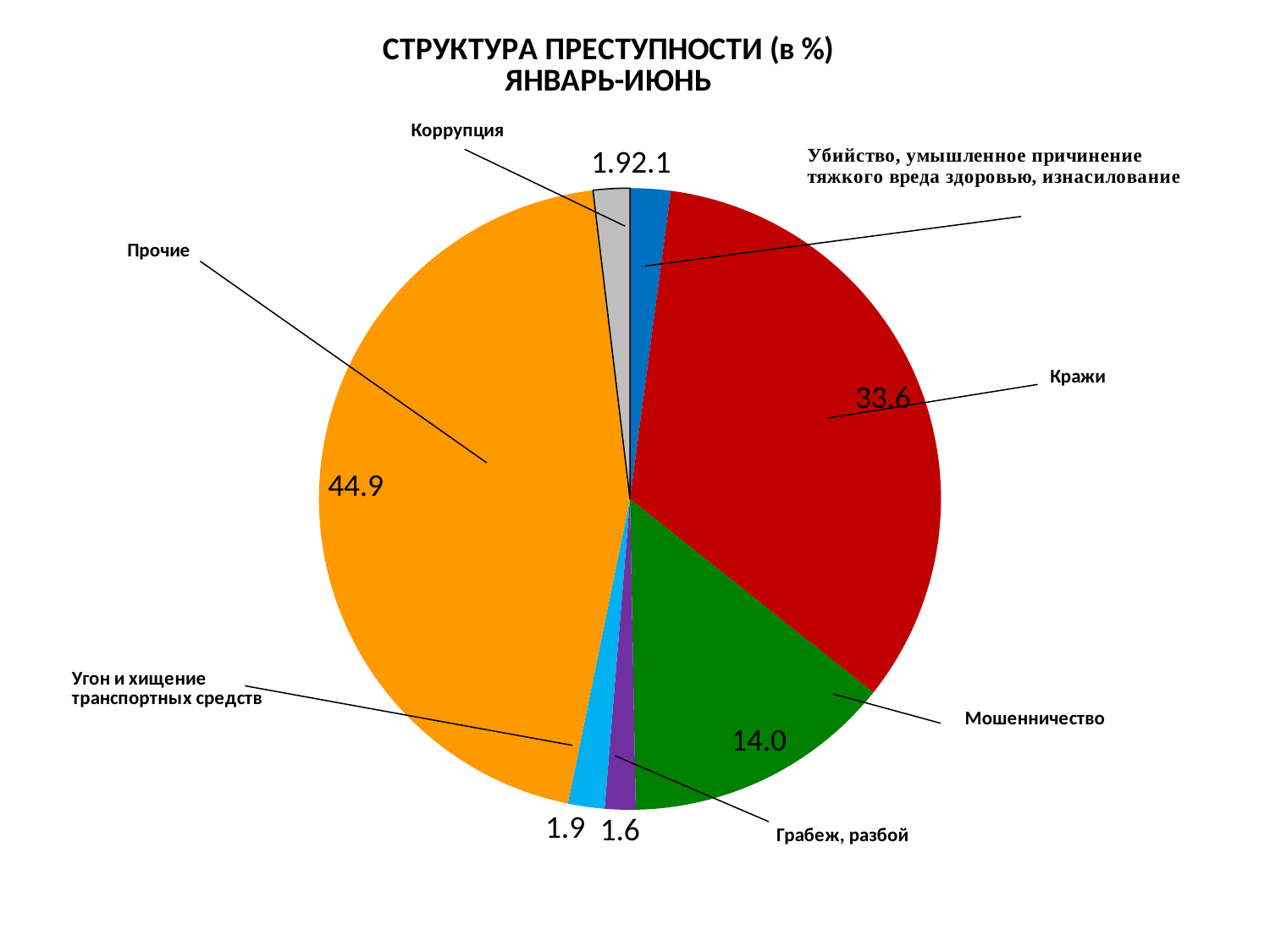
How many categories (slices) does the pie chart have? 7 What type of chart is shown on the slide? Pie chart What is the value shown for Мошенничество? 14.0 What is the value shown for Грабеж, разбой? 1.6 Which category has the largest slice of the pie? Прочие What is the difference between the values for Прочие and Кражи? 11.3 What share of the pie does the Кражи slice represent? 33.6 What is the value shown for the Прочие slice? 44.9 What is the title of the chart? СТРУКТУРА ПРЕСТУПНОСТИ (в %) ЯНВАРЬ-ИЮНЬ Which category has the smallest slice of the pie? Грабеж, разбой Which is larger, the slice for Кражи or the slice for Мошенничество? Кражи What is the value shown for Угон и хищение транспортных средств? 1.9